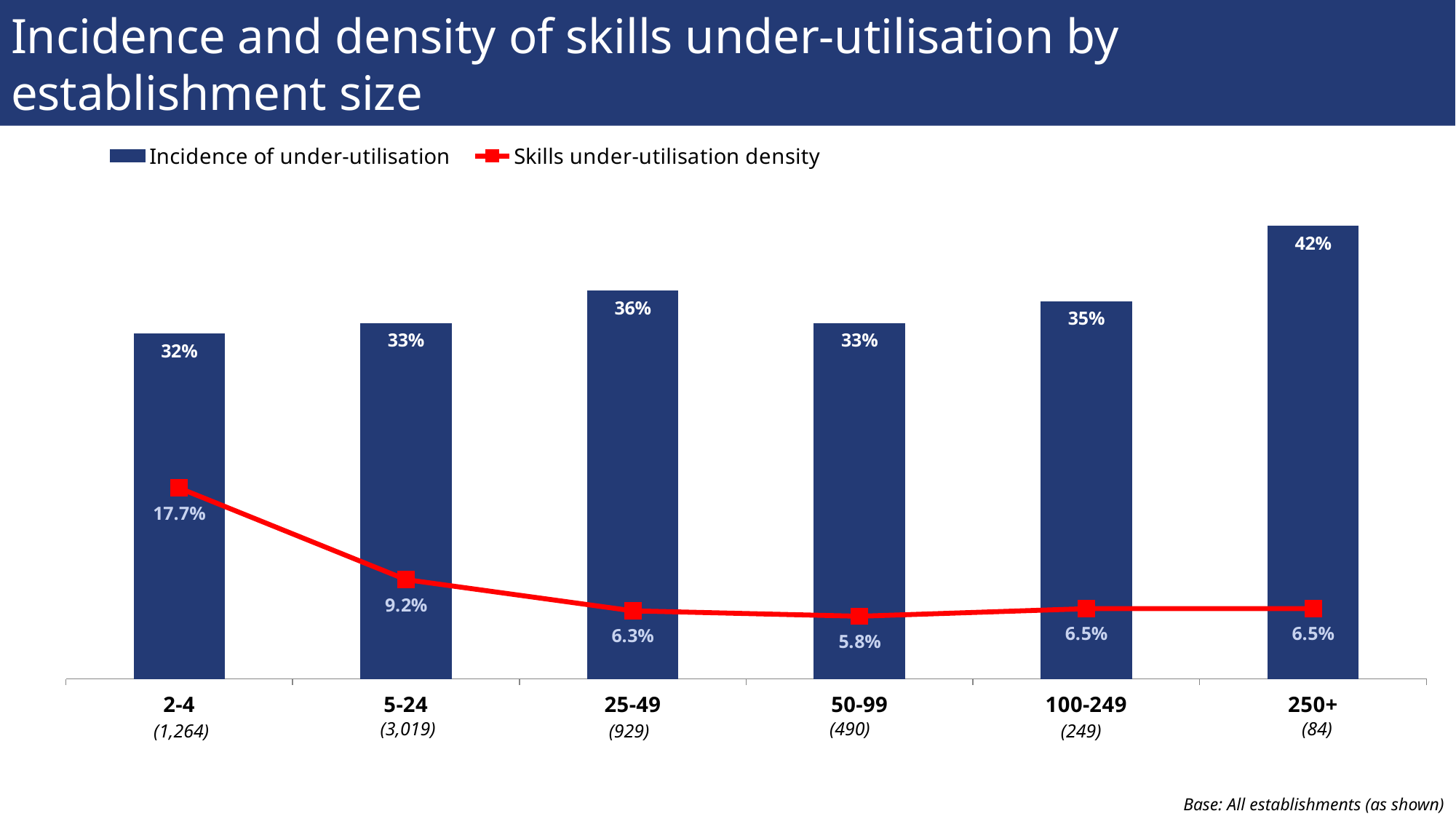
What is the difference in skills under-utilisation density between the 2-4 and 5-24 size bands? 8.5 percentage points How many series does the legend list? 2 What is the base (number of establishments) shown for the 5-24 size band? 3,019 How many establishment size bands are shown on the x axis? 6 Which establishment size band has the highest incidence of under-utilisation? 250+ Which establishment size band has the lowest incidence of under-utilisation? 2-4 What is the difference in incidence of under-utilisation between the 250+ and 2-4 size bands? 10 percentage points What is the skills under-utilisation density for establishments with 2-4 employees? 17.7% What is the skills under-utilisation density for the 50-99 establishment size band? 5.8% Which has a higher incidence of under-utilisation, the 25-49 band or the 100-249 band? 25-49 What is the incidence of under-utilisation for establishments with 250+ employees? 42% Which establishment size band has the lowest skills under-utilisation density? 50-99